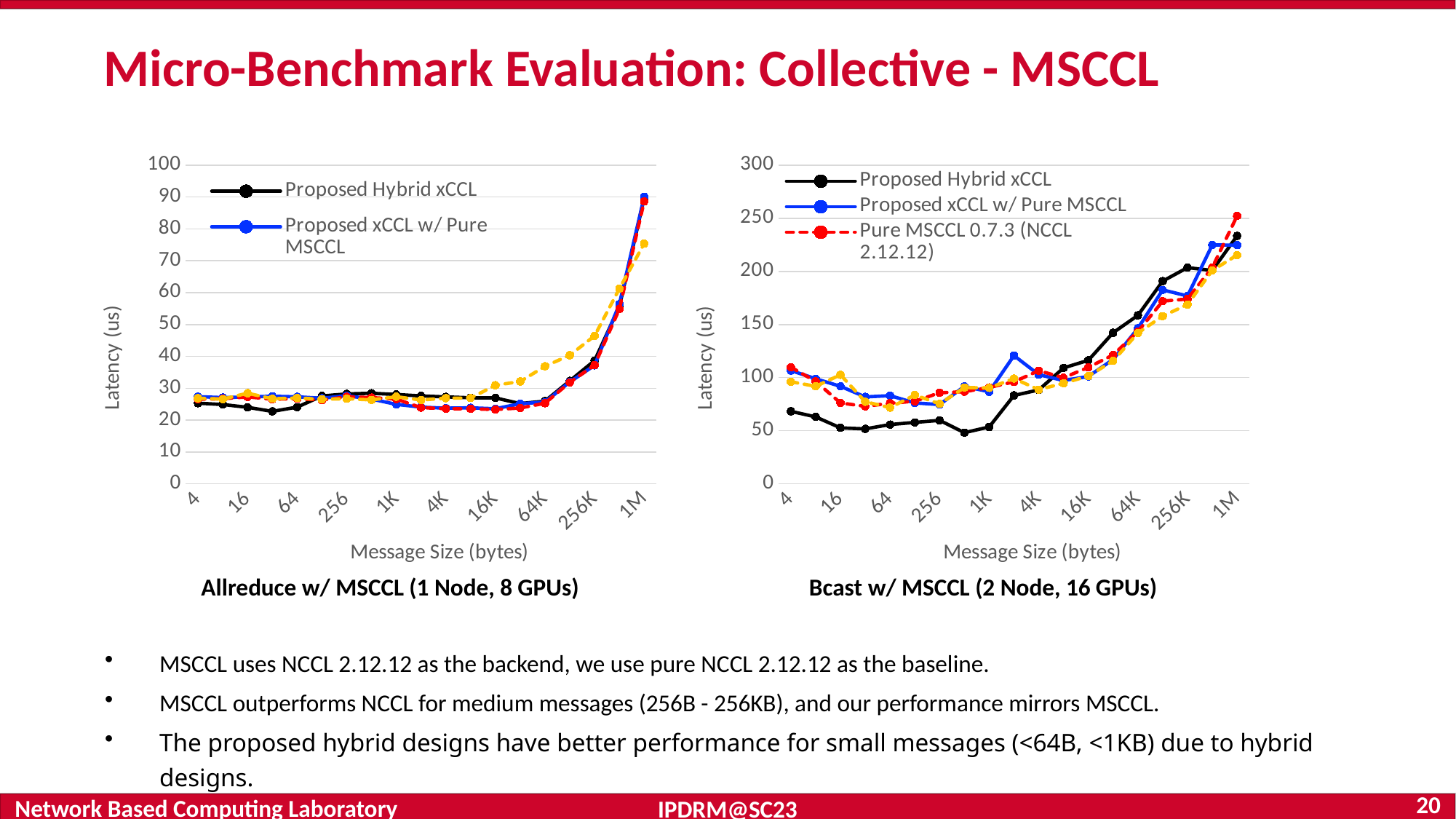
In the Bcast w/ MSCCL (2 Node, 16 GPUs) chart, is the latency of Proposed Hybrid xCCL at 4 bytes greater or less than 50? greater What kind of chart is the Allreduce w/ MSCCL (1 Node, 8 GPUs) chart? line chart How many series does the legend of the Allreduce w/ MSCCL (1 Node, 8 GPUs) chart list? 2 In the Bcast w/ MSCCL (2 Node, 16 GPUs) chart, does the latency of Proposed Hybrid xCCL rise or fall from 4K to 1M? rise In the Allreduce w/ MSCCL (1 Node, 8 GPUs) chart, is the latency of Proposed Hybrid xCCL at 1M greater or less than 80? greater How many message-size labels are shown on the x axis of the Bcast w/ MSCCL (2 Node, 16 GPUs) chart? 10 In the Allreduce w/ MSCCL (1 Node, 8 GPUs) chart, is the latency of Proposed Hybrid xCCL at 4 bytes greater or less than 30? less In the Bcast w/ MSCCL (2 Node, 16 GPUs) chart, which series has the highest latency at 1M? Pure MSCCL 0.7.3 (NCCL 2.12.12) In the Bcast w/ MSCCL (2 Node, 16 GPUs) chart, which series has the higher latency at 4 bytes: Proposed Hybrid xCCL or Pure MSCCL 0.7.3 (NCCL 2.12.12)? Pure MSCCL 0.7.3 (NCCL 2.12.12) What is the y-axis label of the Allreduce w/ MSCCL (1 Node, 8 GPUs) chart? Latency (us) How many series does the legend of the Bcast w/ MSCCL (2 Node, 16 GPUs) chart list? 3